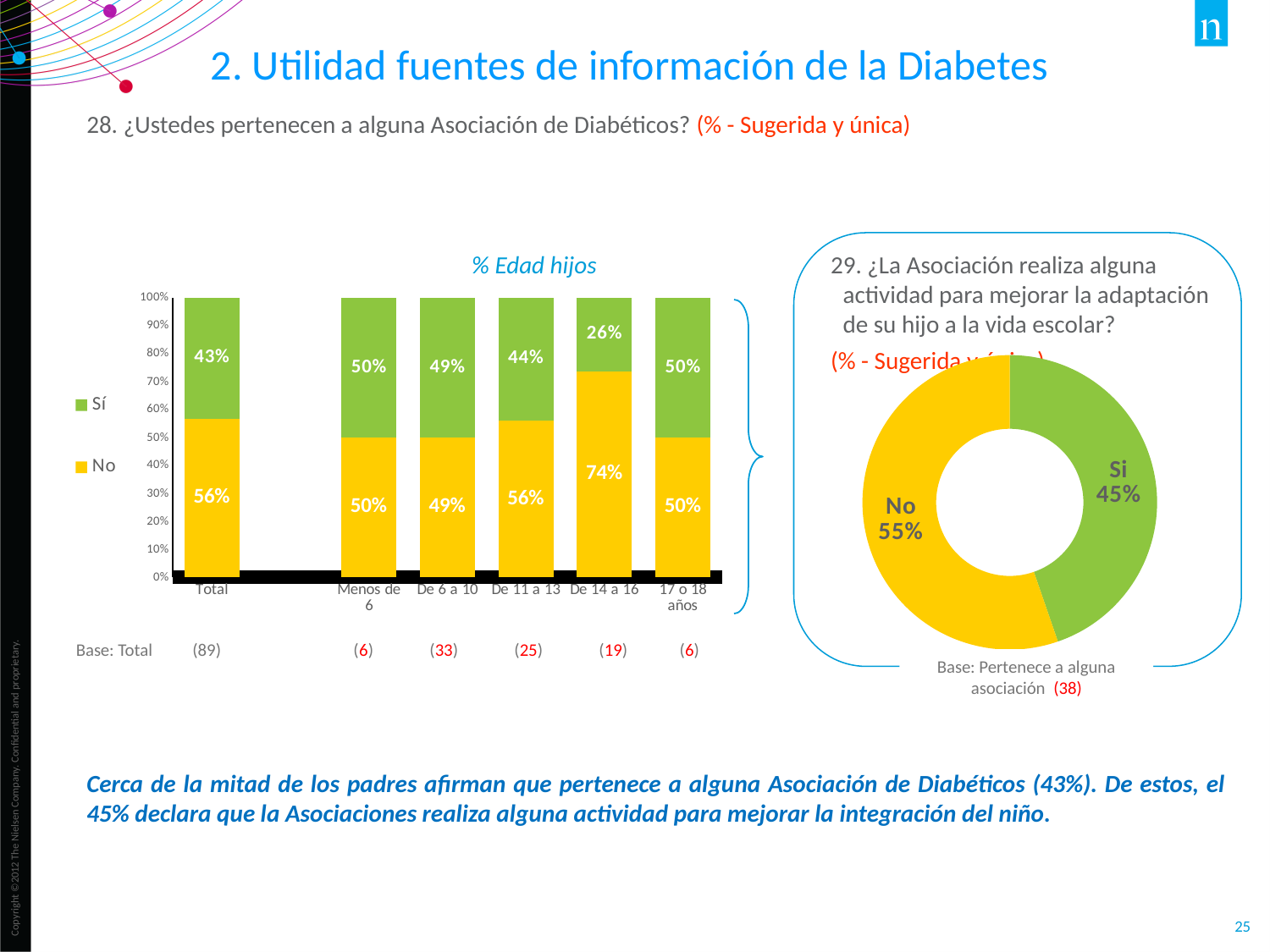
In the stacked bar chart on the left, what is the difference between the 'No' and 'Sí' values for the 'De 14 a 16' category? 48% How many series does the legend of the stacked bar chart on the left list? 2 In the stacked bar chart on the left, is the 'Sí' value for 'Total' larger or smaller than the 'Sí' value for 'Menos de 6'? smaller What kind of chart is the chart on the right of the slide? Donut (pie) chart How many categories are shown on the x axis of the stacked bar chart on the left? 6 In the stacked bar chart on the left, what is the value of 'No' for the 'De 14 a 16' category? 74% In the donut chart on the right, what share does the 'No' slice represent? 55% In the stacked bar chart on the left, which category has the highest 'No' value? De 14 a 16 In the stacked bar chart on the left, what is the value of 'Sí' for the 'De 11 a 13' category? 44% In the donut chart on the right, which slice is larger, 'Si' or 'No'? No In the stacked bar chart on the left, which category has the lowest 'Sí' value? De 14 a 16 In the stacked bar chart on the left, what is the value of 'Sí' for the 'Total' category? 43%